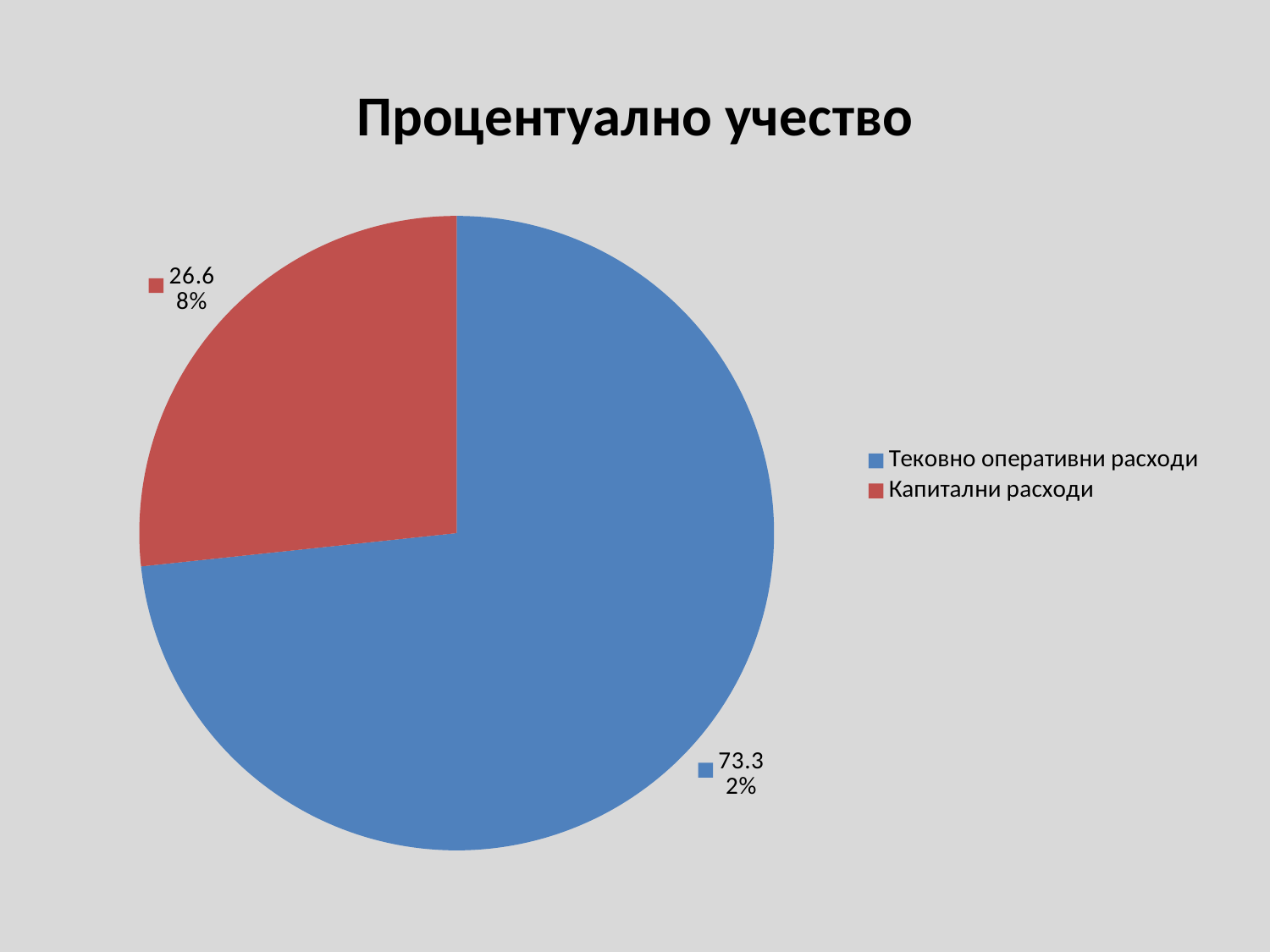
What is the title of the chart? Процентуално учество How many entries does the legend list? 2 What percentage is shown for Капитални расходи? 26.68% Which is larger, the share for Тековно оперативни расходи or for Капитални расходи? Тековно оперативни расходи Which category has the largest share of the pie? Тековно оперативни расходи How many slices does the pie chart have? 2 What kind of chart is shown on the slide? pie chart What is the difference in percentage points between Тековно оперативни расходи and Капитални расходи? 46.64 Which category has the smallest share of the pie? Капитални расходи What percentage is shown for Тековно оперативни расходи? 73.32% What colour is the slice for Капитални расходи? red